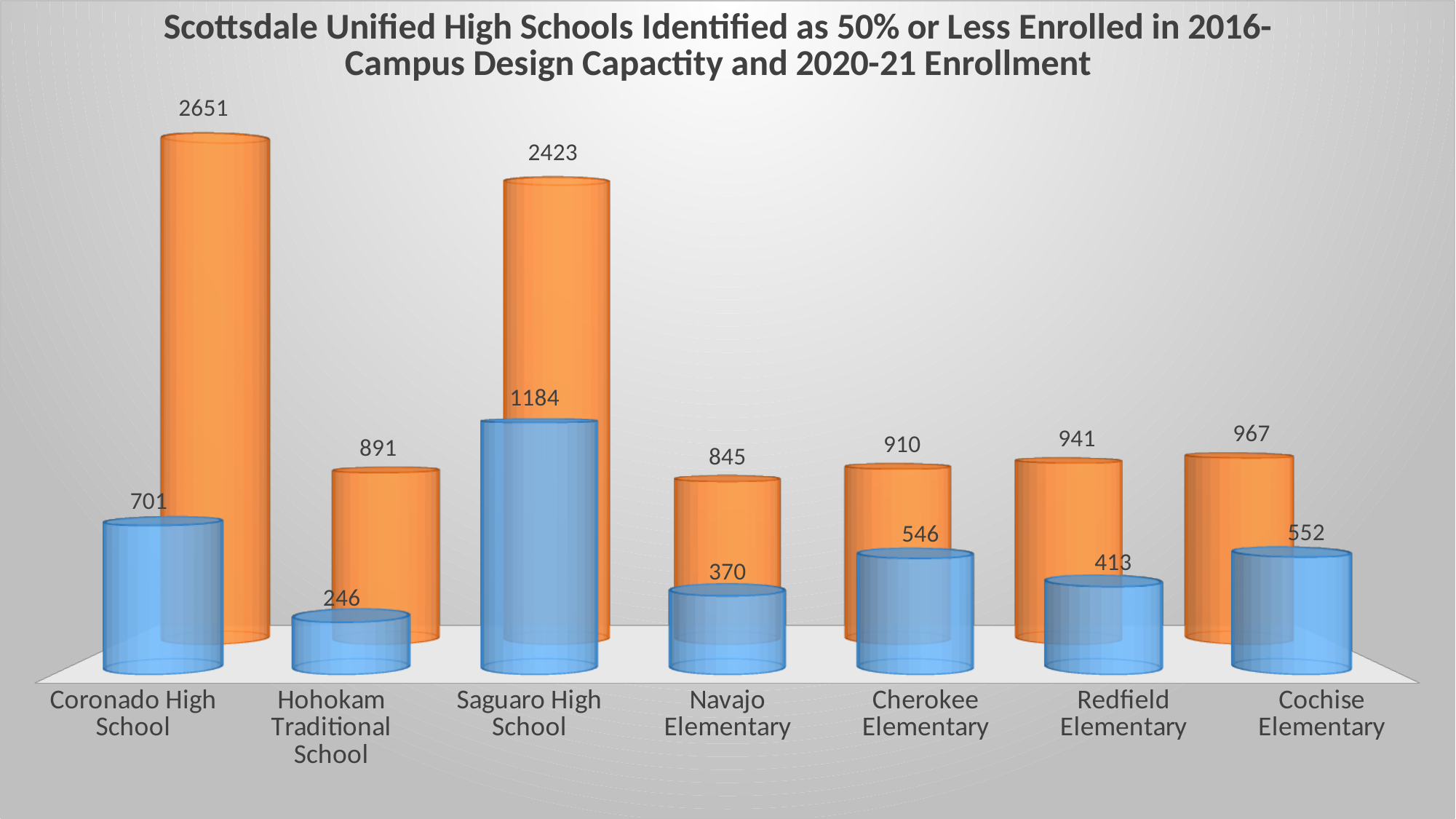
How many schools are shown on the x axis? 7 What is the title of the chart? Scottsdale Unified High Schools Identified as 50% or Less Enrolled in 2016- Campus Design Capactity and 2020-21 Enrollment What is the value of the orange bar for Cochise Elementary? 967 Which school has the highest orange bar? Coronado High School Which is larger, the blue bar for Cherokee Elementary or the blue bar for Redfield Elementary? Cherokee Elementary What is the difference between the orange bars for Saguaro High School and Coronado High School? 228 What is the difference between the orange and blue bars for Navajo Elementary? 475 What is the value of the blue bar for Saguaro High School? 1184 What is the value of the blue bar for Hohokam Traditional School? 246 Which school has the lowest blue bar? Hohokam Traditional School What kind of chart is shown on the slide? Bar chart What is the value of the orange bar for Coronado High School? 2651